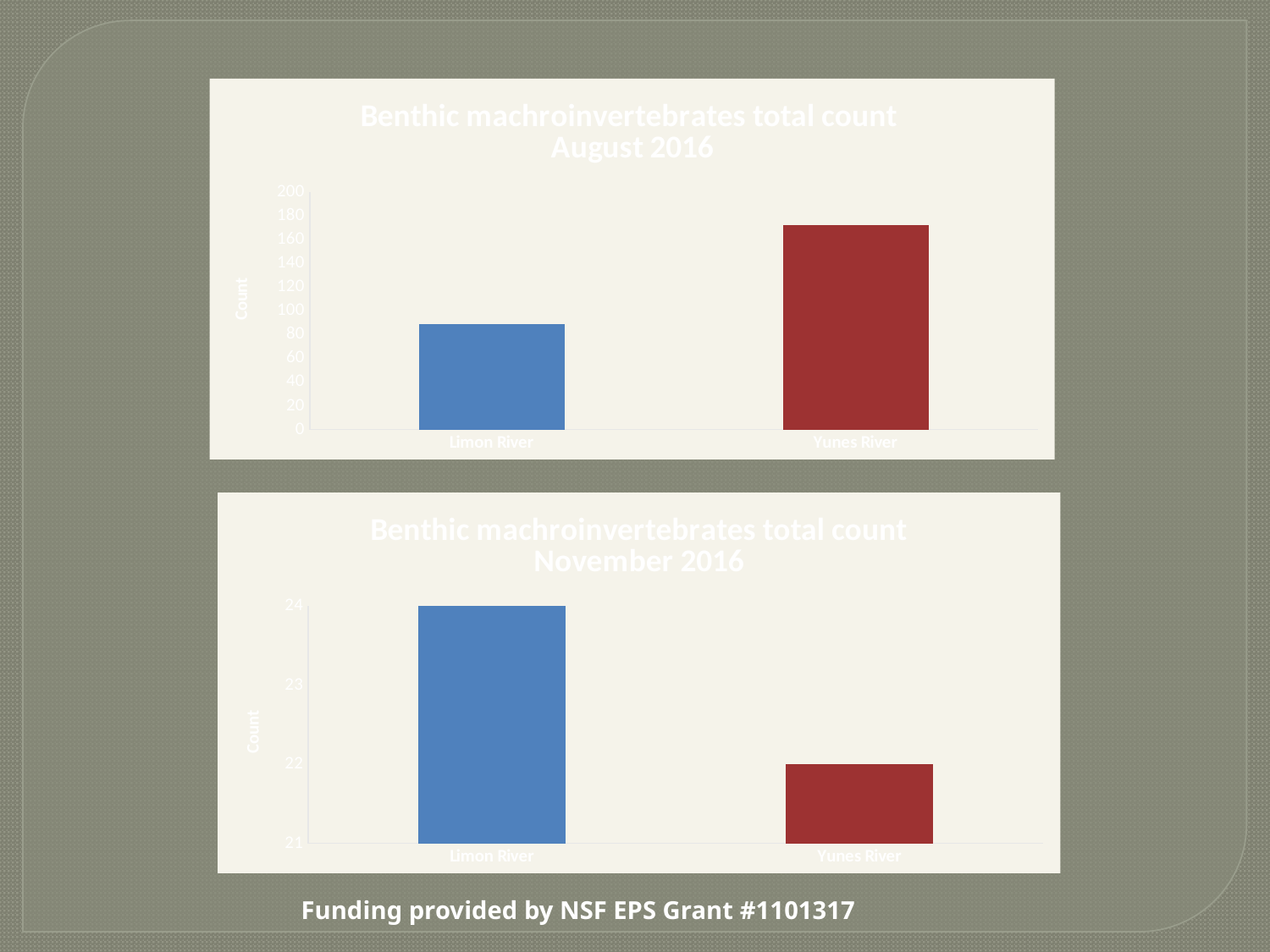
In the top chart (August 2016), which river has the lower count? Limon River In the top chart (August 2016), which river has the higher count? Yunes River In the bottom chart (November 2016), what is the difference between the Limon River and Yunes River counts? 2 What kind of chart is the bottom chart (November 2016)? Bar chart How many categories are shown in the top chart (August 2016)? 2 In the bottom chart (November 2016), what is the count for Limon River? 24 In the bottom chart (November 2016), what is the count for Yunes River? 22 In the bottom chart (November 2016), is the count for Limon River or Yunes River larger? Limon River In the bottom chart (November 2016), which river has the higher count? Limon River What is the title of the top chart? Benthic machroinvertebrates total count August 2016 In the top chart (August 2016), is the value for Limon River greater or less than 100? less In the top chart (August 2016), is the value for Yunes River greater or less than 160? greater